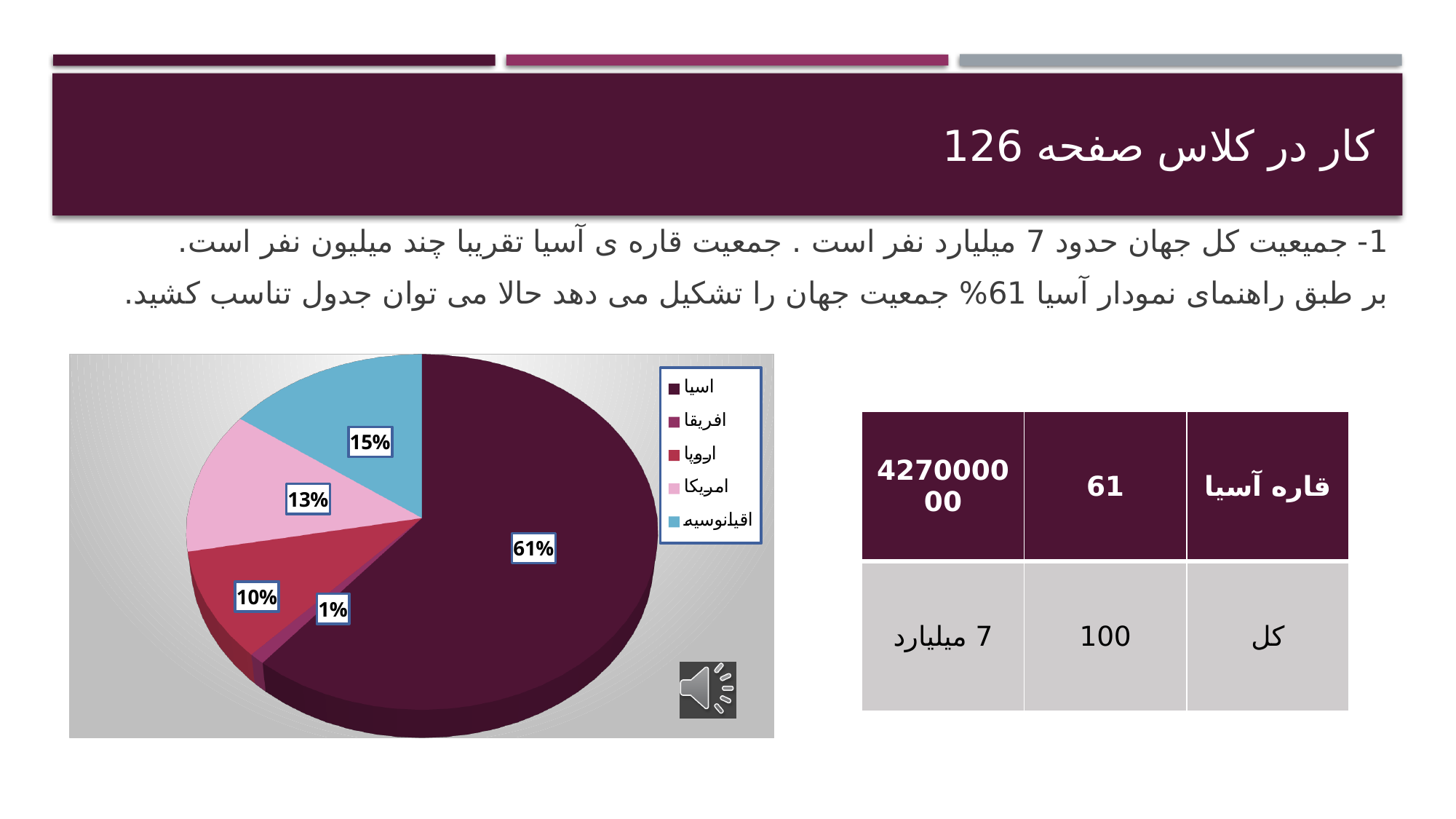
What percentage does the slice for امریکا (America) show? 13% What colour is the slice for اقیانوسیه? blue What is the difference between the percentages for اسیا and اقیانوسیه? 46% What percentage does the slice for افریقا (Africa) show? 1% Which category has the largest slice of the pie? اسیا How many categories does the legend of the pie chart list? 5 Which category has the smallest slice of the pie? افریقا What kind of chart is shown on the slide? pie chart Which is larger, the slice for امریکا or the slice for اروپا? امریکا What percentage does the slice for اروپا (Europe) show? 10% What percentage does the slice for اقیانوسیه (Oceania) show? 15% What percentage does the slice for اسیا (Asia) show? 61%